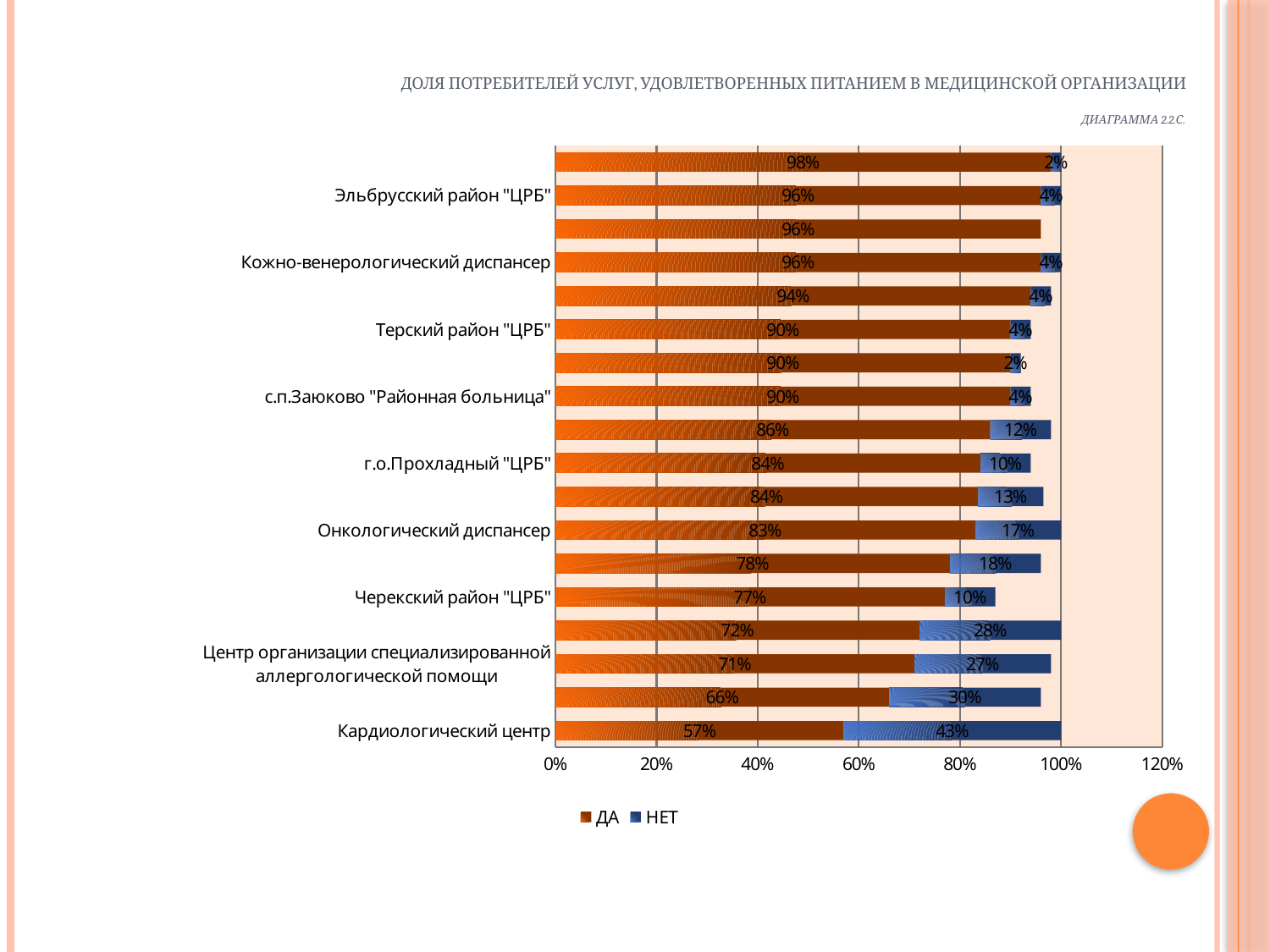
How many series does the legend list? 2 Which labelled category has the lowest ДА value? Кардиологический центр What is the НЕТ value for Кардиологический центр? 43% Which has a larger ДА value, Онкологический диспансер or Черекский район "ЦРБ"? Онкологический диспансер What is the ДА value for Кардиологический центр? 57% What is the difference between the ДА and НЕТ values for Кардиологический центр? 14 percentage points What is the НЕТ value for Черекский район "ЦРБ"? 10% What is the ДА value for г.о.Прохладный "ЦРБ"? 84% What are the two series named in the legend? ДА and НЕТ Which labelled category has the highest НЕТ value? Кардиологический центр What kind of chart is shown on the slide? bar chart What is the ДА value for Онкологический диспансер? 83%